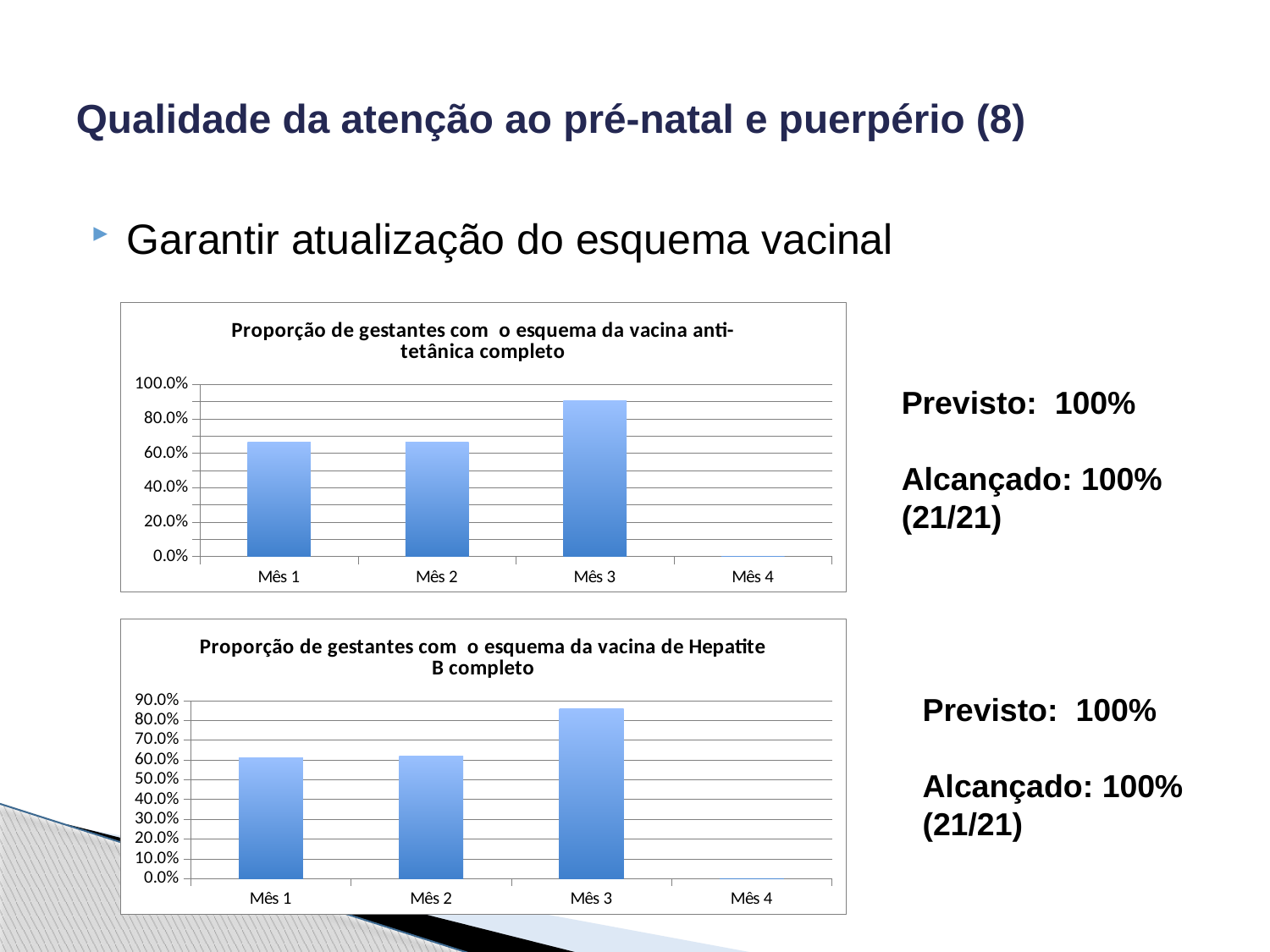
In the top chart (vacina anti-tetânica), which month has the highest value? Mês 3 What kind of chart is the top chart, 'Proporção de gestantes com o esquema da vacina anti-tetânica completo'? bar chart In the top chart (vacina anti-tetânica), is the value for Mês 1 greater or less than 80.0%? less In the bottom chart (vacina de Hepatite B), which month has the highest value? Mês 3 What is the highest value shown on the y axis of the bottom chart (vacina de Hepatite B)? 90.0% In the top chart (vacina anti-tetânica), which is larger, the value for Mês 3 or the value for Mês 2? Mês 3 In the bottom chart (vacina de Hepatite B), is the value for Mês 1 greater or less than 70.0%? less In the bottom chart (vacina de Hepatite B), which month has the lowest value? Mês 4 What kind of chart is the bottom chart, 'Proporção de gestantes com o esquema da vacina de Hepatite B completo'? bar chart In the bottom chart (vacina de Hepatite B), is the value for Mês 3 greater or less than 80.0%? greater In the top chart (vacina anti-tetânica), how many months are shown on the x axis? 4